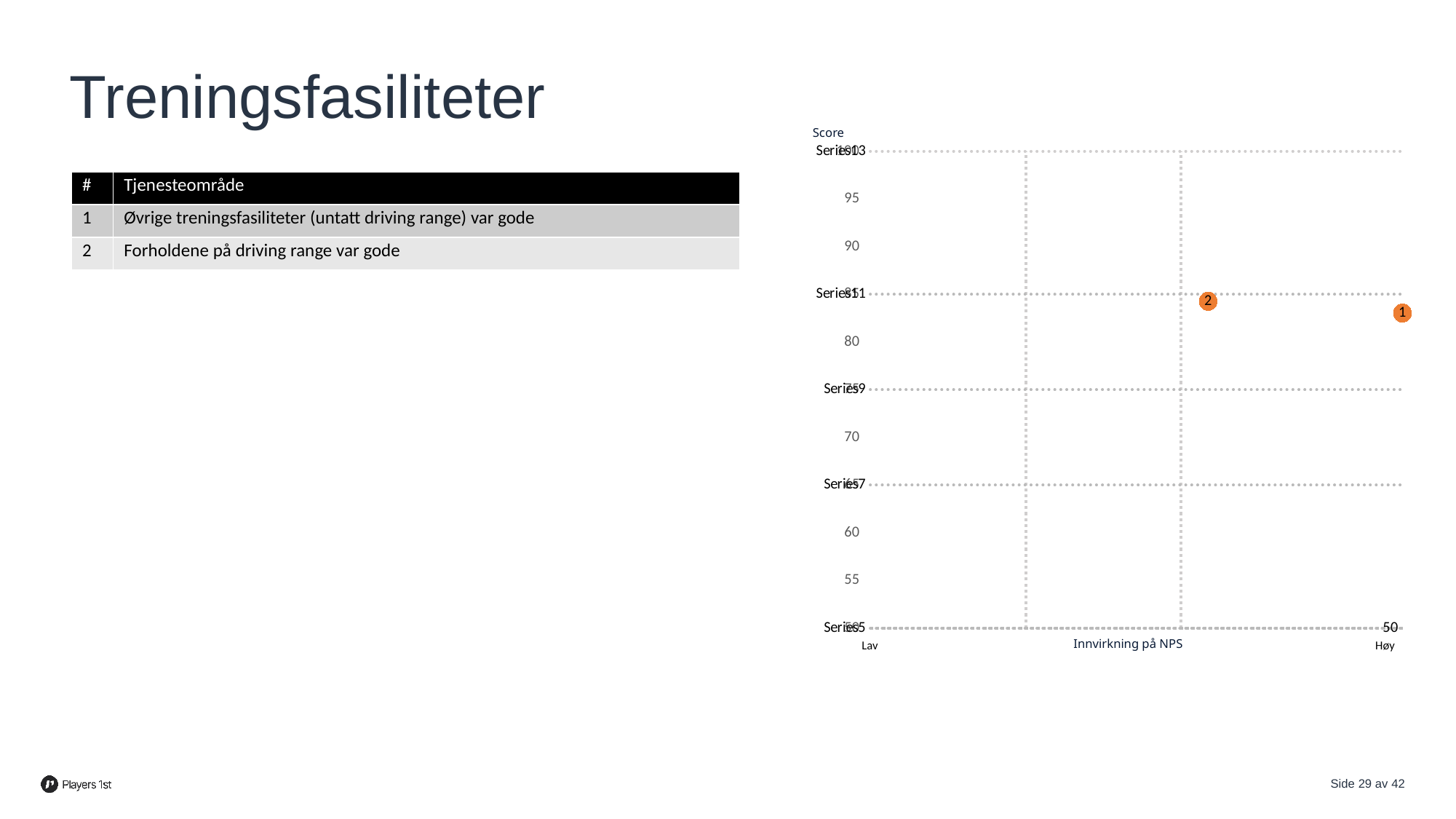
What kind of chart is shown on the slide? scatter chart What is the title of the vertical axis of the chart? Score What is the title of the horizontal axis of the chart? Innvirkning på NPS How many data points are plotted on the chart? 2 What is the lowest value shown on the Score axis? 50 Which point has the higher Innvirkning på NPS (is further to the right), point 1 or point 2? point 1 Is the Score for point 2 greater or less than 90? less Is the Score for point 2 greater or less than 80? greater Is the Score for point 1 greater or less than 80? greater What is the highest value shown on the Score axis? 100 Which point is furthest to the right on the Innvirkning på NPS axis? 1